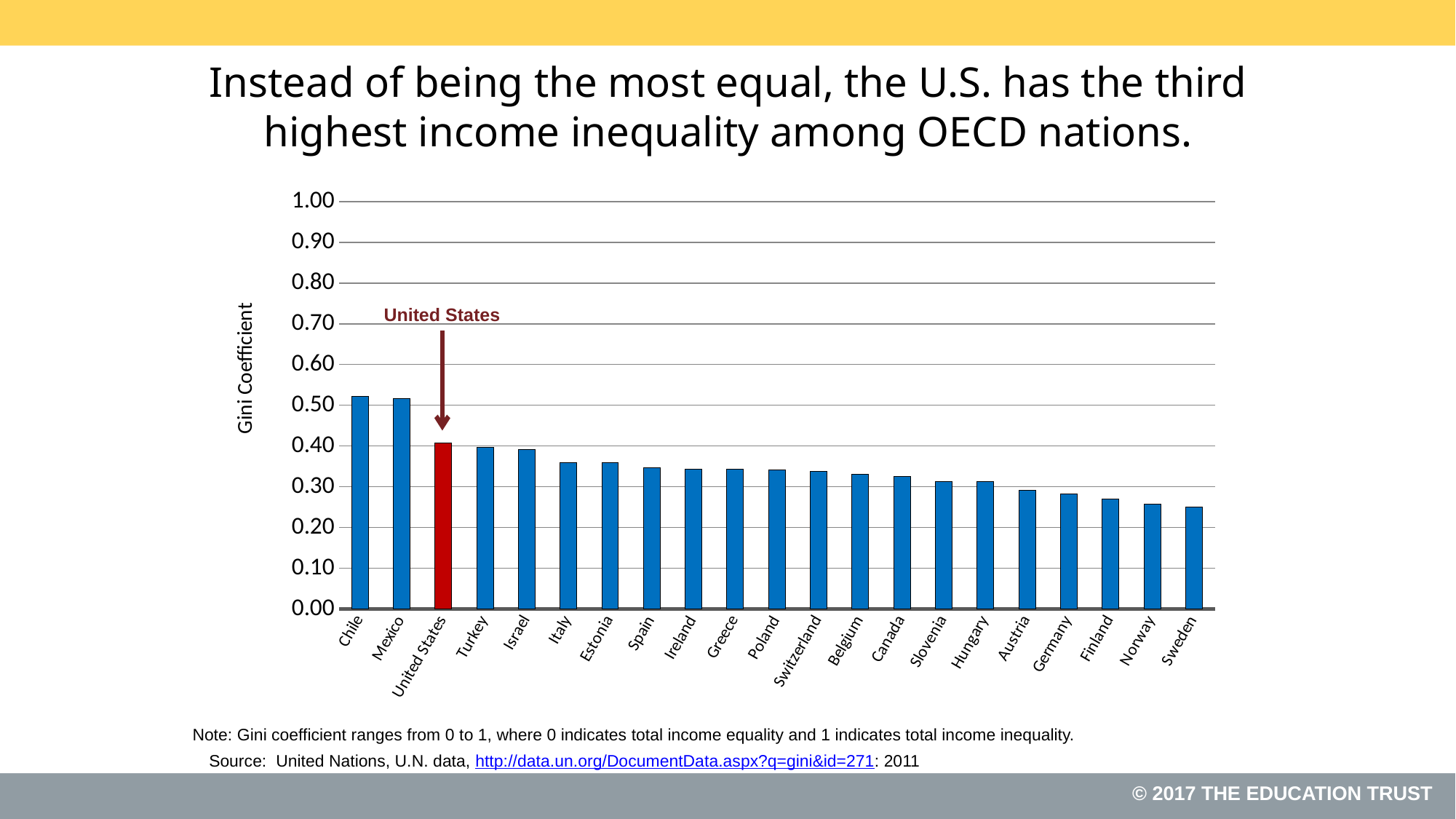
Is the Gini coefficient for Sweden greater or less than 0.30? less Do the Gini coefficient values rise or fall moving from left to right across the countries? Fall How many countries are plotted in the chart? 21 Which has a higher Gini coefficient, Turkey or Germany? Turkey Is the Gini coefficient for Chile greater or less than 0.50? greater What kind of chart is shown on the slide? Bar chart Which has a higher Gini coefficient, the United States or Italy? United States Is the Gini coefficient for Mexico greater or less than 0.50? greater Which country's bar is highlighted in red? United States